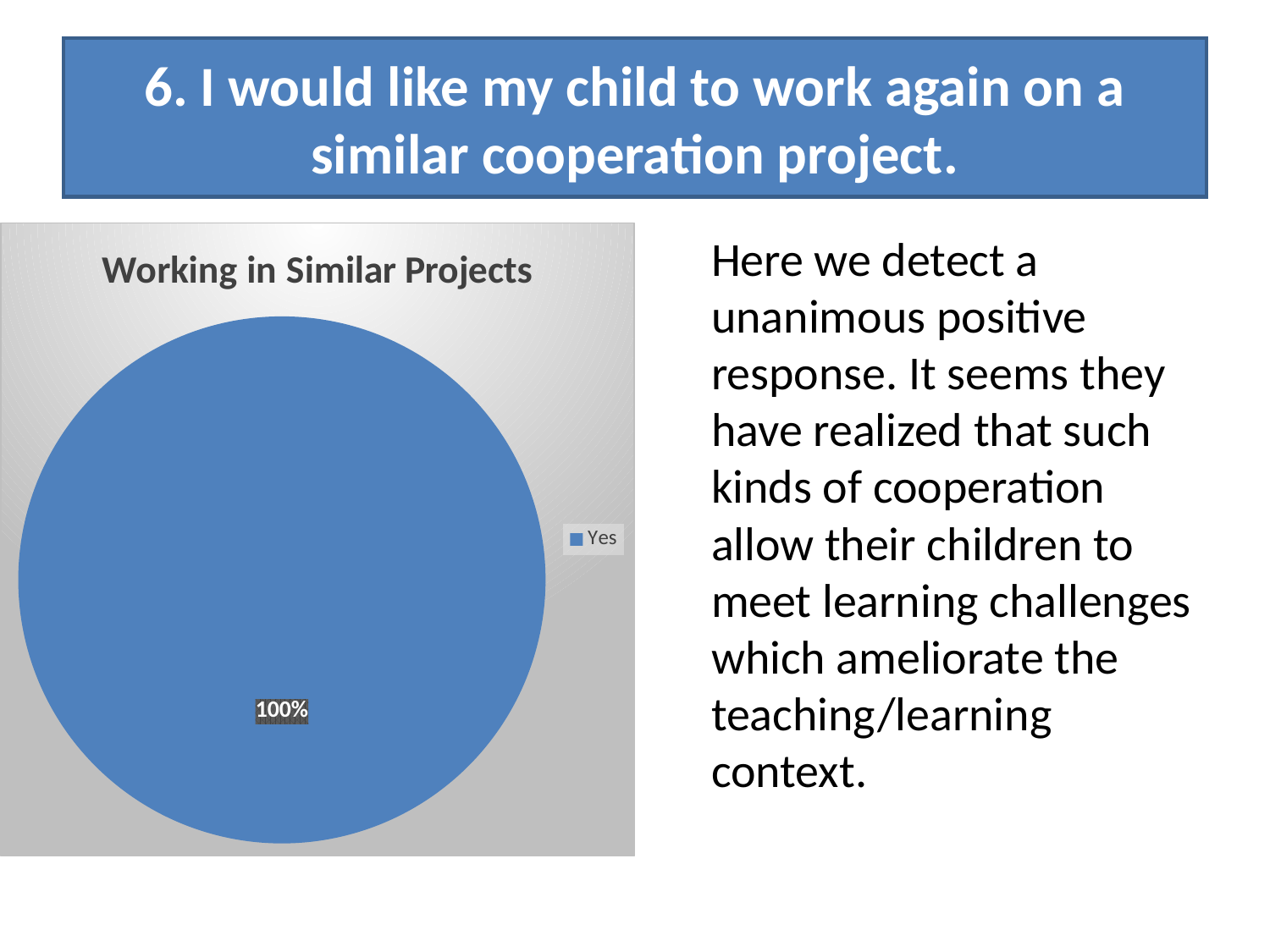
What is the only category shown in the legend? Yes What percentage is shown for the Yes slice? 100% What is the title of the chart? Working in Similar Projects Which category has the largest share of the pie? Yes How many slices does the pie chart have? 1 What kind of chart is shown on the slide? pie chart How many entries does the legend list? 1 What share of the pie does the Yes slice take up? 100%